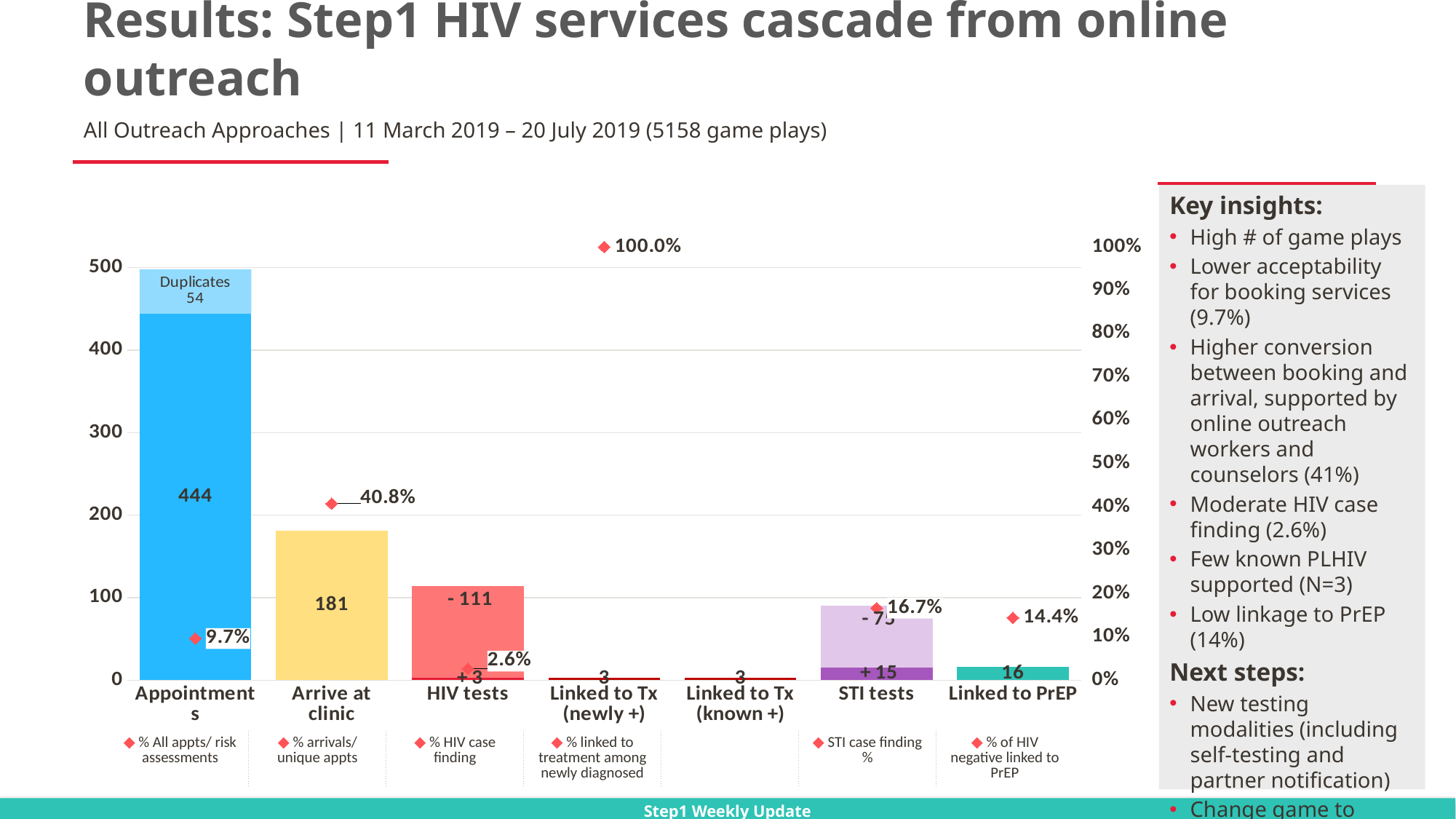
What is the STI case finding % shown for STI tests? 16.7% What is the value of the main bar for Arrive at clinic? 181 Which category has the tallest bar? Appointments Which is larger, the value for Arrive at clinic or the value for Linked to PrEP? Arrive at clinic What percentage is shown for % arrivals/unique appts at Arrive at clinic? 40.8% What is the value for Linked to PrEP? 16 What is the difference between the 444 Appointments and the 181 Arrive at clinic values? 263 What is the % HIV case finding value shown above HIV tests? 2.6% How many Duplicates are shown in the Appointments bar? 54 How many categories are shown on the x axis? 7 What is the total of the stacked Appointments bar (444 plus 54 Duplicates)? 498 What percentage is shown for % linked to treatment among newly diagnosed? 100.0%